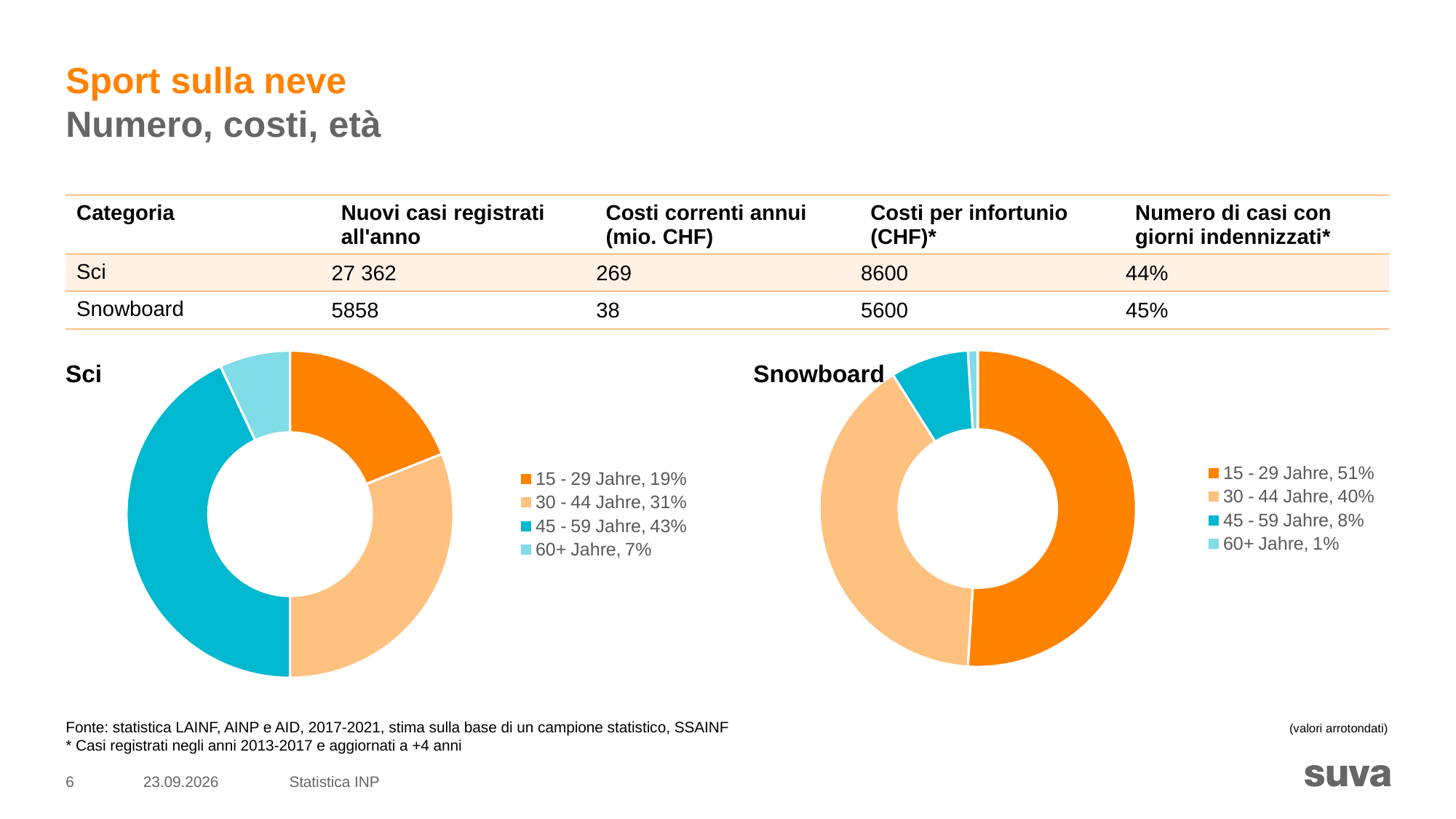
How many age groups does the legend of the Snowboard chart list? 4 What type of chart is used for the Sci age distribution? Doughnut chart In the Snowboard chart, what is the difference in percentage points between the 15 - 29 Jahre and 30 - 44 Jahre shares? 11 In the Snowboard chart, which colour represents the 30 - 44 Jahre group? Light orange In the Sci chart, which is larger: the share for 30 - 44 Jahre or for 45 - 59 Jahre? 45 - 59 Jahre Which chart shows a larger share for the 60+ Jahre group, Sci or Snowboard? Sci In the Sci chart, what is the difference in percentage points between the 30 - 44 Jahre and 15 - 29 Jahre shares? 12 In the Sci chart, what is the combined share of the 15 - 29 Jahre and 30 - 44 Jahre groups? 50% In the Snowboard chart, which age group has the smallest share? 60+ Jahre In the Sci chart, what share of cases is in the 45 - 59 Jahre age group? 43% In the Snowboard chart, what share of cases is in the 15 - 29 Jahre age group? 51% In the Sci chart, which age group has the largest share? 45 - 59 Jahre